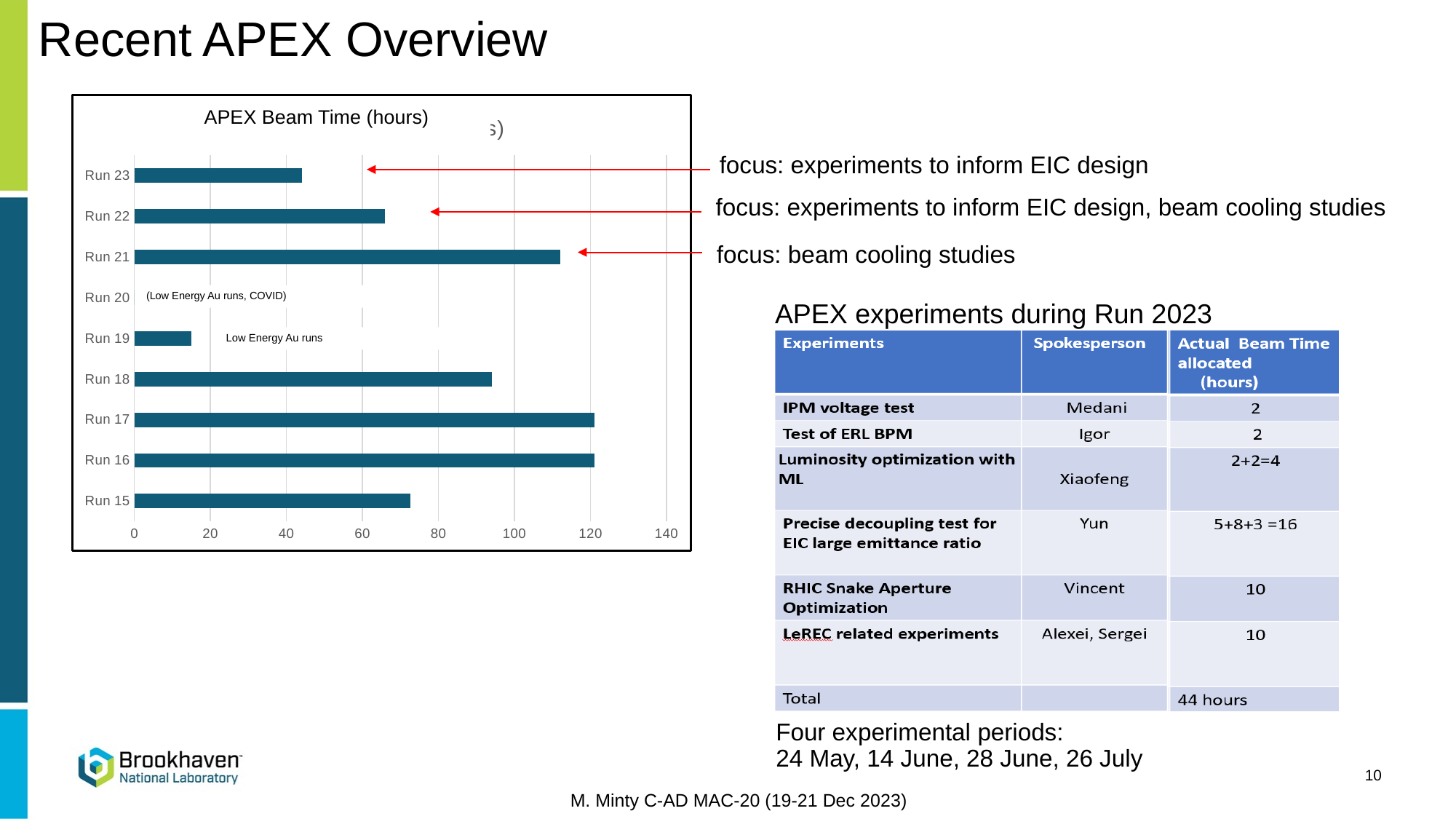
Is the value for Run 19 greater or less than 20? less Is the value for Run 23 greater or less than 60? less Is the value for Run 15 greater or less than 60? greater Do the beam time values rise or fall going from Run 21 to Run 23? fall How many runs are listed on the chart's vertical axis? 9 What is the title of the chart? APEX Beam Time (hours) Which has more beam time, Run 18 or Run 15? Run 18 Which has more beam time, Run 21 or Run 22? Run 21 What kind of chart is shown on the slide? bar chart What annotation is shown next to Run 20 on the chart? (Low Energy Au runs, COVID)